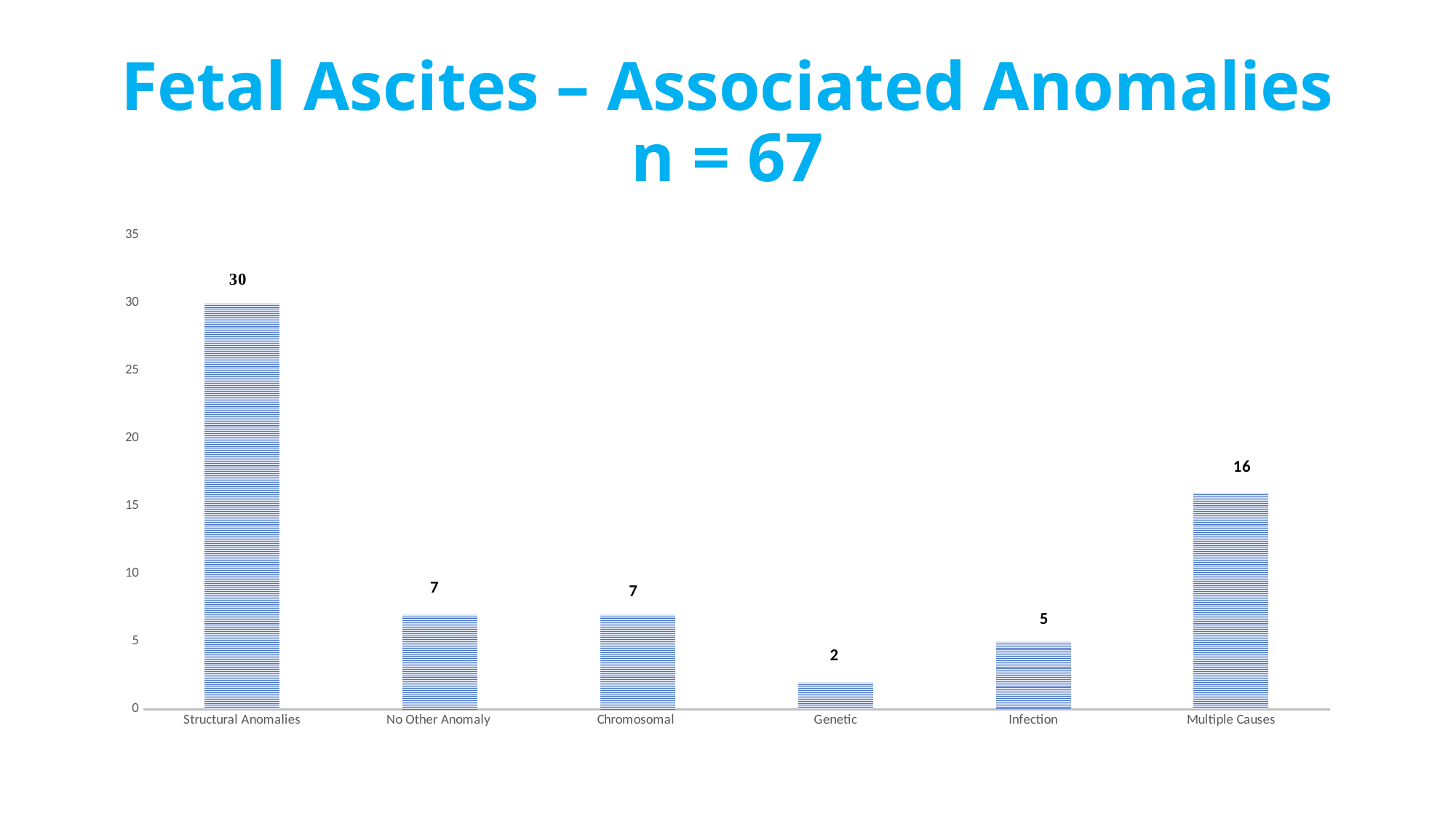
What kind of chart is shown on the slide? Bar chart What is the value for Structural Anomalies? 30 Which category has the lowest value? Genetic How many categories are shown on the x axis? 6 What is the value for Infection? 5 What is the title of the slide? Fetal Ascites – Associated Anomalies n = 67 Which category has the highest value? Structural Anomalies Which is larger, the value for Multiple Causes or the value for No Other Anomaly? Multiple Causes What is the value for Genetic? 2 What is the difference between the values for Structural Anomalies and Multiple Causes? 14 What is the value for Multiple Causes? 16 What is the difference between the values for Chromosomal and Infection? 2